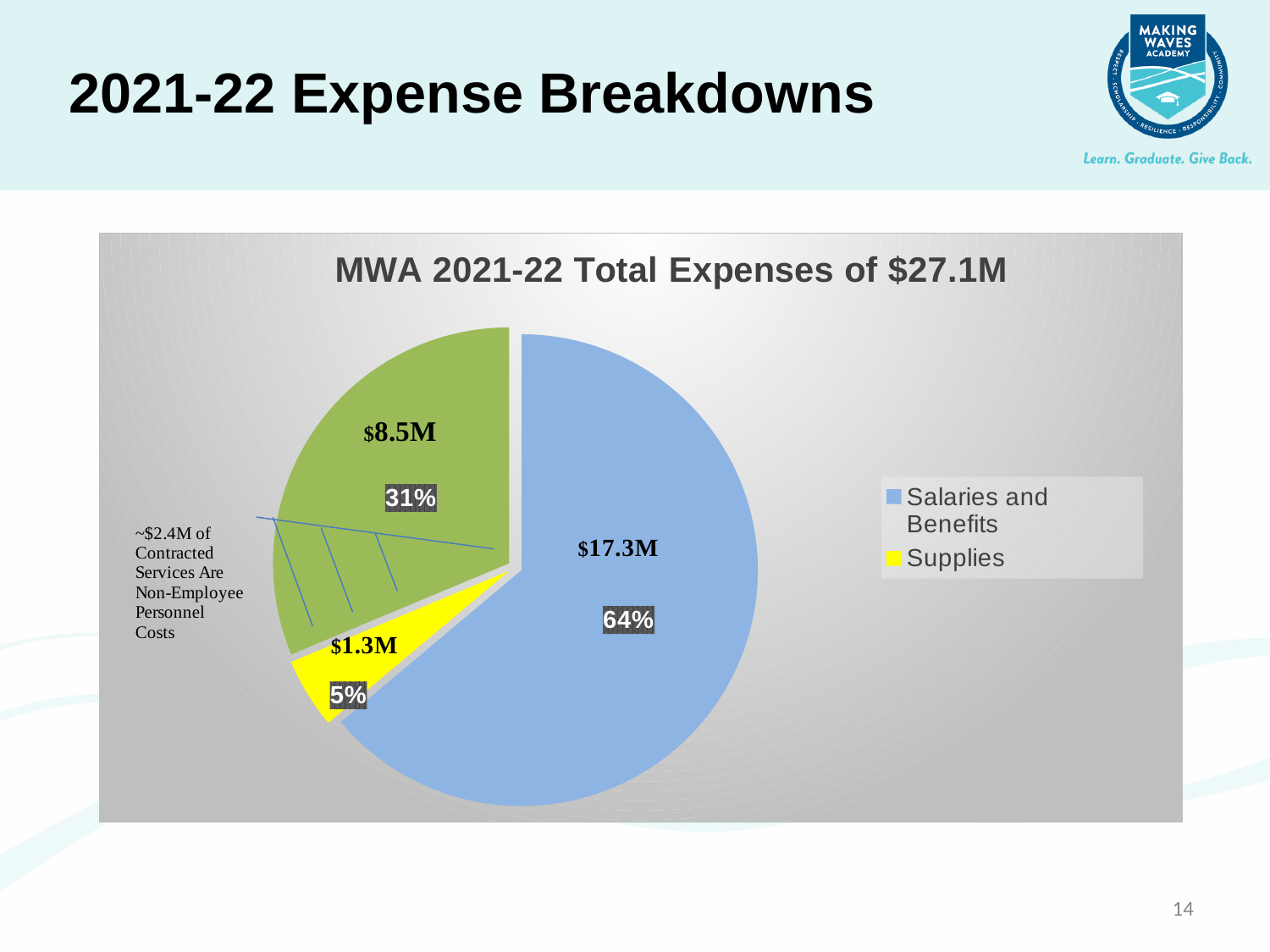
What share of the pie does Salaries and Benefits represent? 64% What kind of chart is shown on the slide? Pie chart What is the value shown for Salaries and Benefits? $17.3M Which slice of the pie is the smallest? Supplies Which slice of the pie is the largest? Salaries and Benefits How many entries does the legend list? 2 By how many percentage points does the Salaries and Benefits share exceed the Supplies share? 59 percentage points What is the value shown for Supplies? $1.3M What share of the pie does the slice labelled $8.5M represent? 31% What share of the pie does Supplies represent? 5% How many slices does the pie chart have? 3 What is the title of the chart? MWA 2021-22 Total Expenses of $27.1M